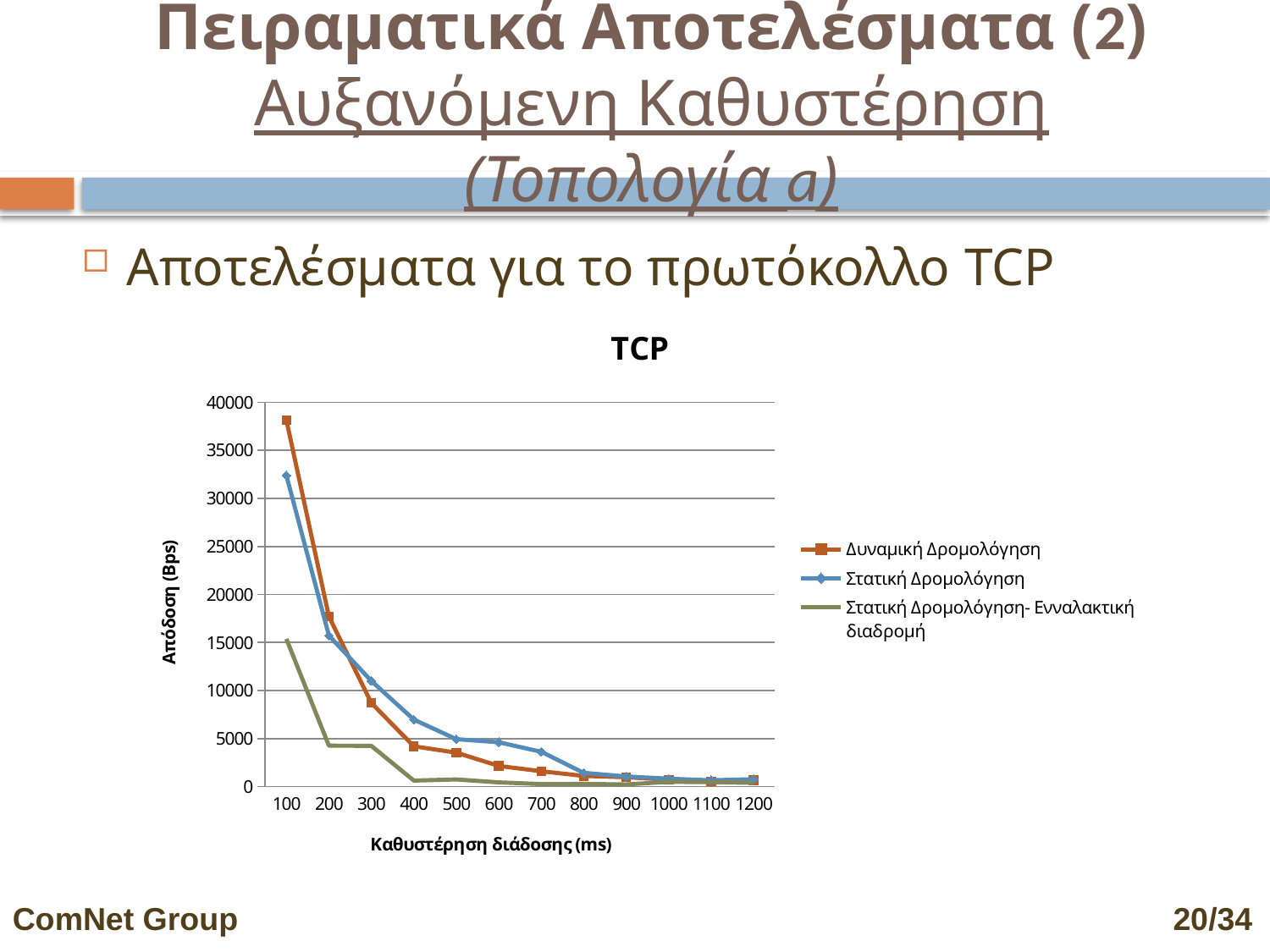
Which series has the lowest value at 200 ms? Στατική Δρομολόγηση- Ενναλακτική διαδρομή How many series does the legend of the TCP chart list? 3 At 100 ms, which series has the higher value: Δυναμική Δρομολόγηση or Στατική Δρομολόγηση? Δυναμική Δρομολόγηση Do the values of the Δυναμική Δρομολόγηση series rise or fall as the propagation delay increases? fall What is the title of the y axis of the TCP chart? Απόδοση (Bps) How many delay values are shown along the x axis of the TCP chart? 12 Is the value for Στατική Δρομολόγηση- Ενναλακτική διαδρομή at 400 ms greater or less than 5000? less Is the value for Στατική Δρομολόγηση- Ενναλακτική διαδρομή at 100 ms greater or less than 20000? less Is the value for Στατική Δρομολόγηση at 100 ms greater or less than 35000? less What kind of chart is shown on the slide? line chart At 400 ms, which series has the higher value: Στατική Δρομολόγηση or Δυναμική Δρομολόγηση? Στατική Δρομολόγηση